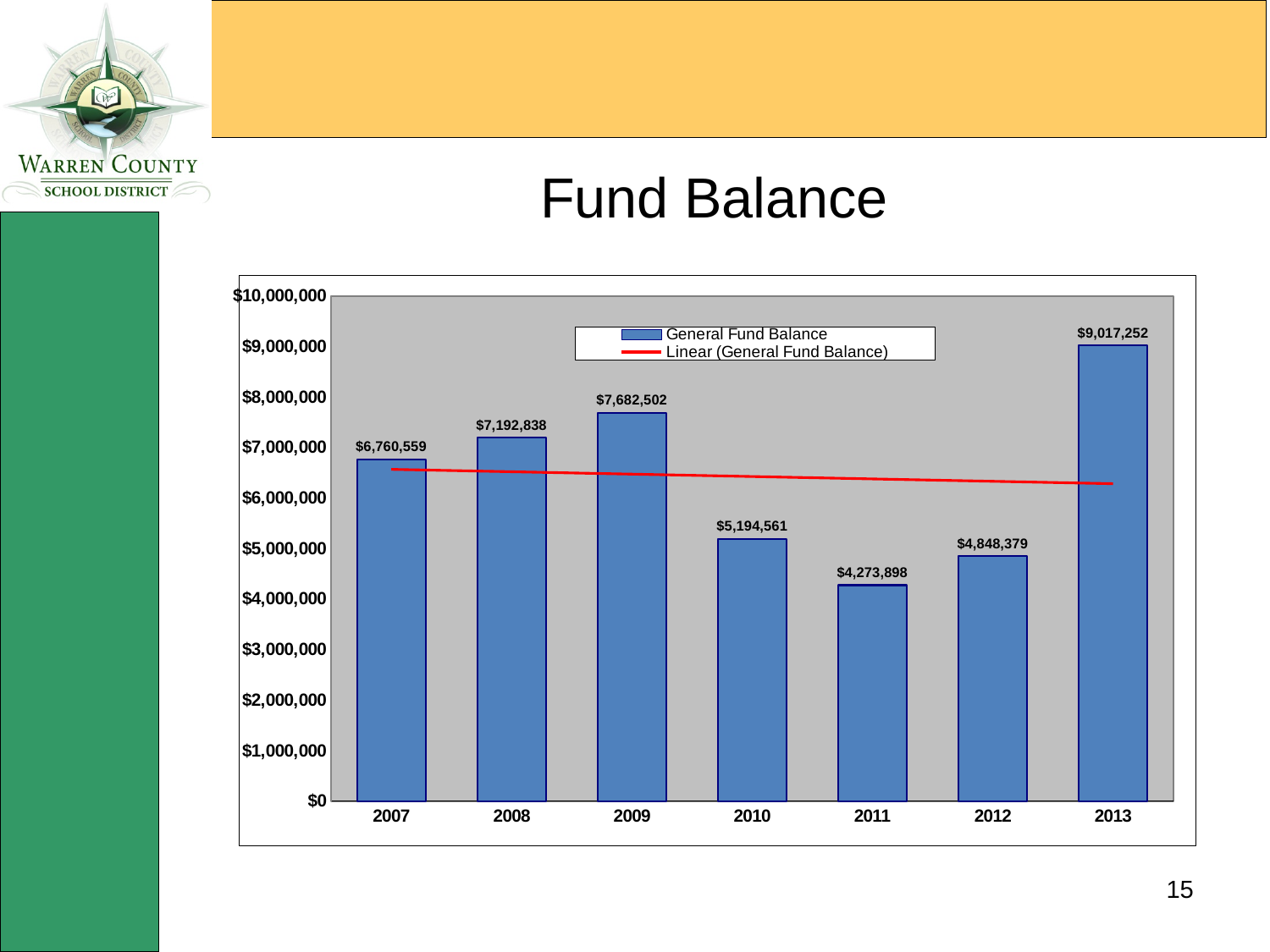
What is the difference between the General Fund Balance in 2009 and in 2008? $489,664 What is the General Fund Balance for 2011? $4,273,898 How many entries does the chart legend list? 2 Which year has the lowest General Fund Balance? 2011 Which year has a larger General Fund Balance, 2010 or 2012? 2010 What is the difference between the General Fund Balance in 2013 and in 2011? $4,743,354 What type of chart is used to show the Fund Balance? Bar chart What is the General Fund Balance for 2009? $7,682,502 How many years are shown on the x axis of the chart? 7 Is the General Fund Balance for 2008 greater or less than $7,000,000? greater What is the General Fund Balance for 2013? $9,017,252 Which year has the highest General Fund Balance? 2013